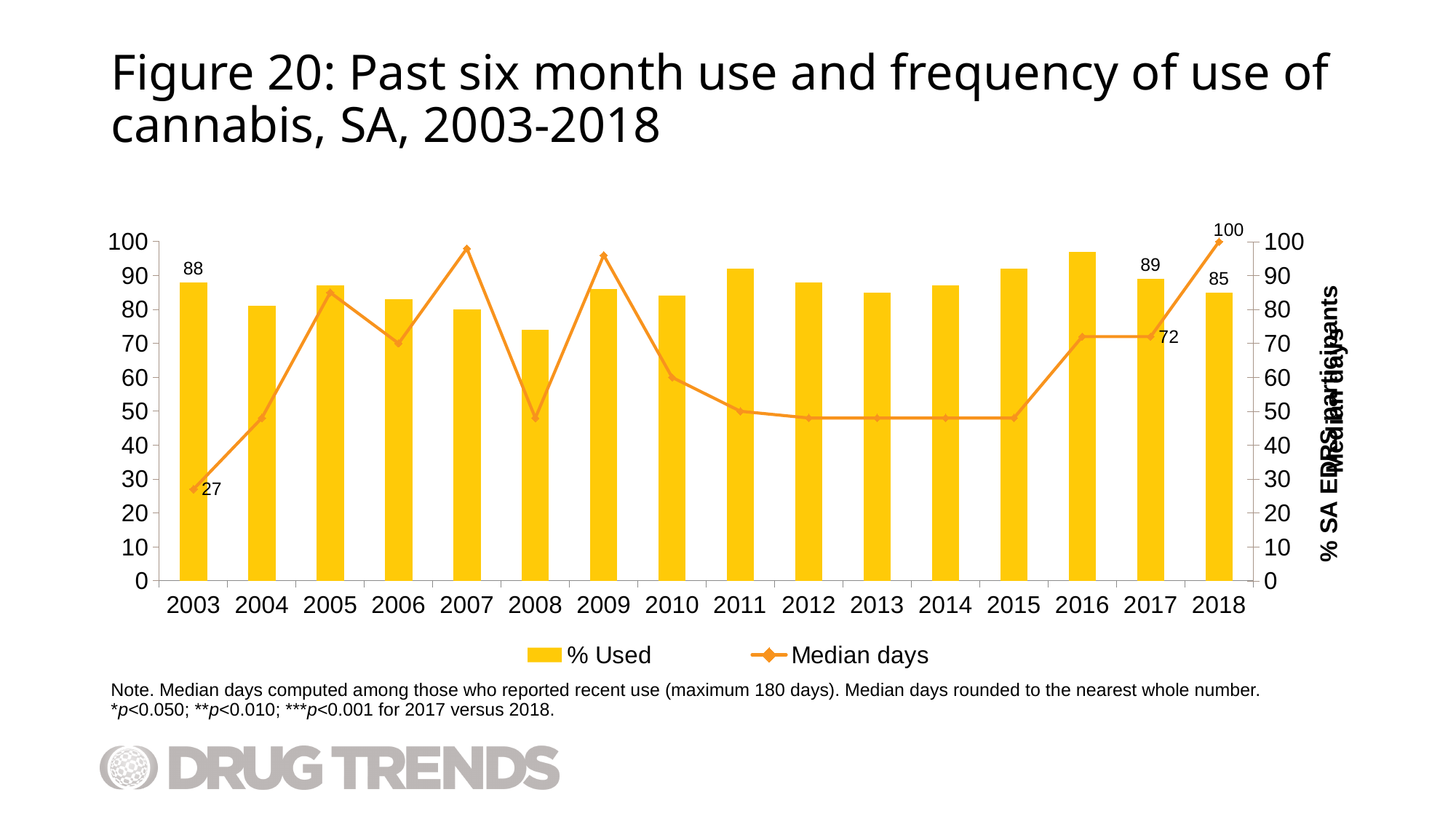
What is the Median days value for 2018? 100 Which series is drawn as a line with markers? Median days What is the % Used value for 2003? 88 What is the Median days value for 2003? 27 Which year has the lowest % Used value? 2008 What is the % Used value for 2017? 89 How many years are shown on the x axis? 16 What is the difference between the Median days values for 2018 and 2017? 28 Which is larger, the % Used value for 2003 or for 2018? 2003 Is the % Used value for 2008 greater or less than 80? less Which year has the highest Median days value? 2018 How many series does the legend list? 2